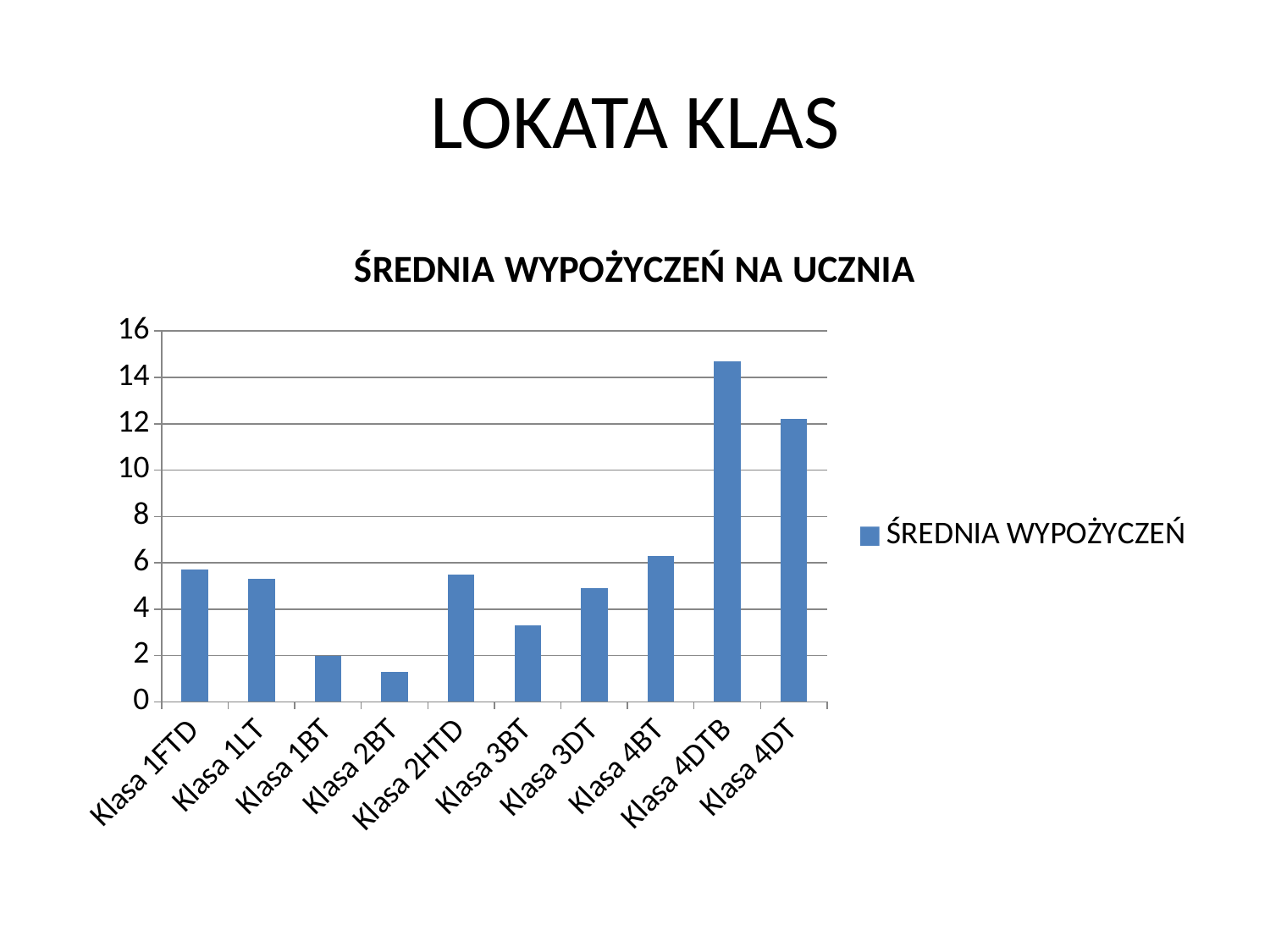
Is the value for Klasa 3BT greater or less than 4? less Is the value for Klasa 4DTB greater or less than 14? greater What type of chart is shown on the slide? bar chart What is the legend entry for the series shown in the chart? ŚREDNIA WYPOŻYCZEŃ How many classes (categories) are shown on the x axis? 10 Which has a higher value, Klasa 4DTB or Klasa 4DT? Klasa 4DTB Which has a higher value, Klasa 1BT or Klasa 2BT? Klasa 1BT Which class has the highest average number of loans per student? Klasa 4DTB Which class has the lowest average number of loans per student? Klasa 2BT How many series does the legend list? 1 What is the title of the chart? ŚREDNIA WYPOŻYCZEŃ NA UCZNIA